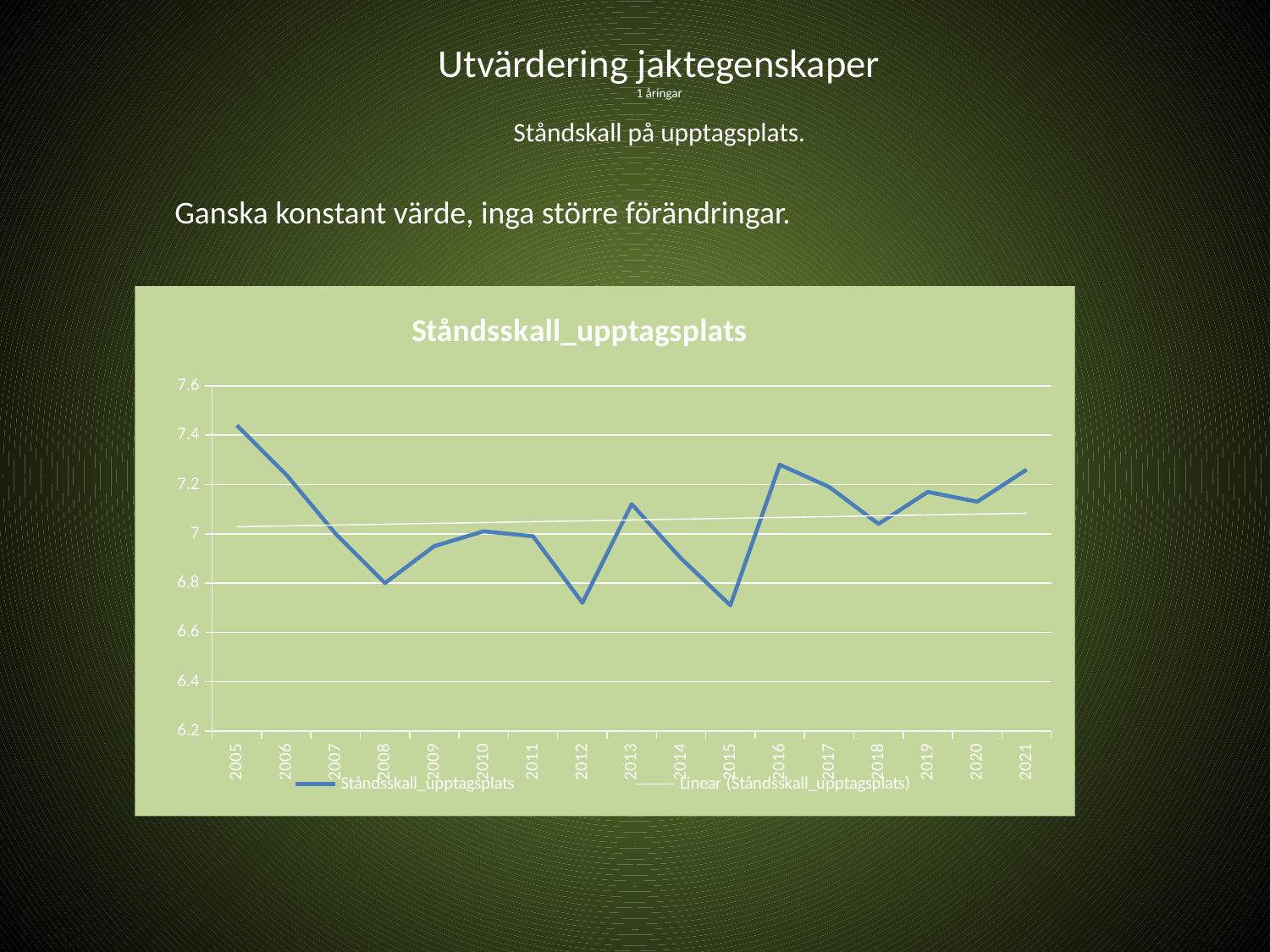
How many entries does the chart legend list? 2 Which year has the larger value, 2016 or 2018? 2016 What is the title of the chart? Ståndsskall_upptagsplats What kind of chart is shown on the slide? line chart How many years are plotted along the x axis of the chart? 17 Is the value for 2008 greater or less than 7? less Is the value for 2012 greater or less than 6.8? less Is the value for 2005 greater or less than 7.2? greater Which year has the highest value in the chart? 2005 Which year has the larger value, 2012 or 2013? 2013 Do the values rise or fall from 2005 to 2008? fall